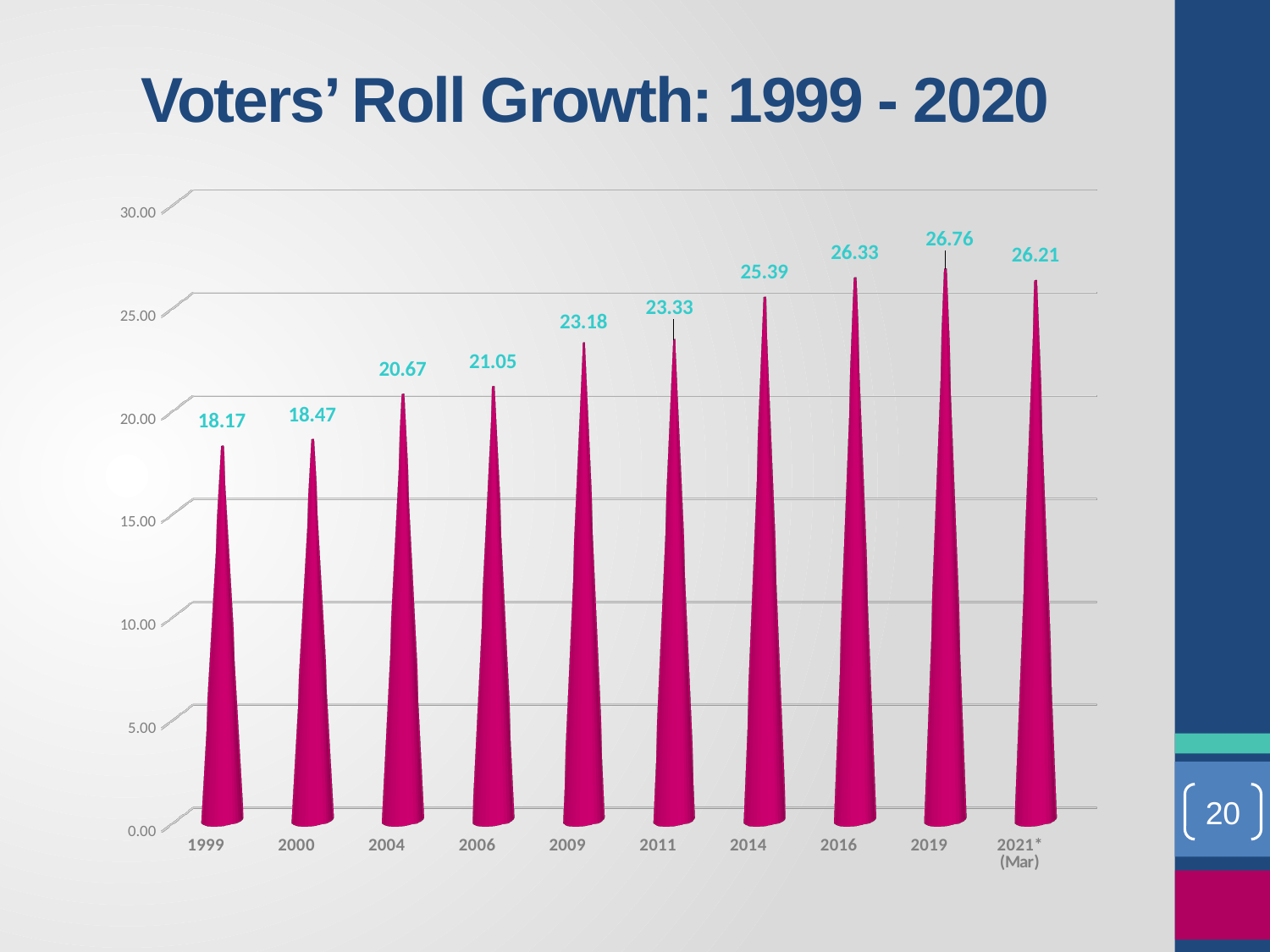
Which year has the highest value? 2019 What is the value for 2014? 25.39 What kind of chart is shown on the slide? bar chart What is the difference between the values for 2019 and 1999? 8.59 What is the value for 2021* (Mar)? 26.21 How many years are shown on the x axis? 10 Which is larger, the value for 2016 or the value for 2021* (Mar)? 2016 Is the value for 2009 greater or less than 25.00? less What is the title of the slide? Voters' Roll Growth: 1999 - 2020 Do the values generally rise or fall from 1999 to 2019? rise Which year has the lowest value? 1999 What is the value for 1999? 18.17